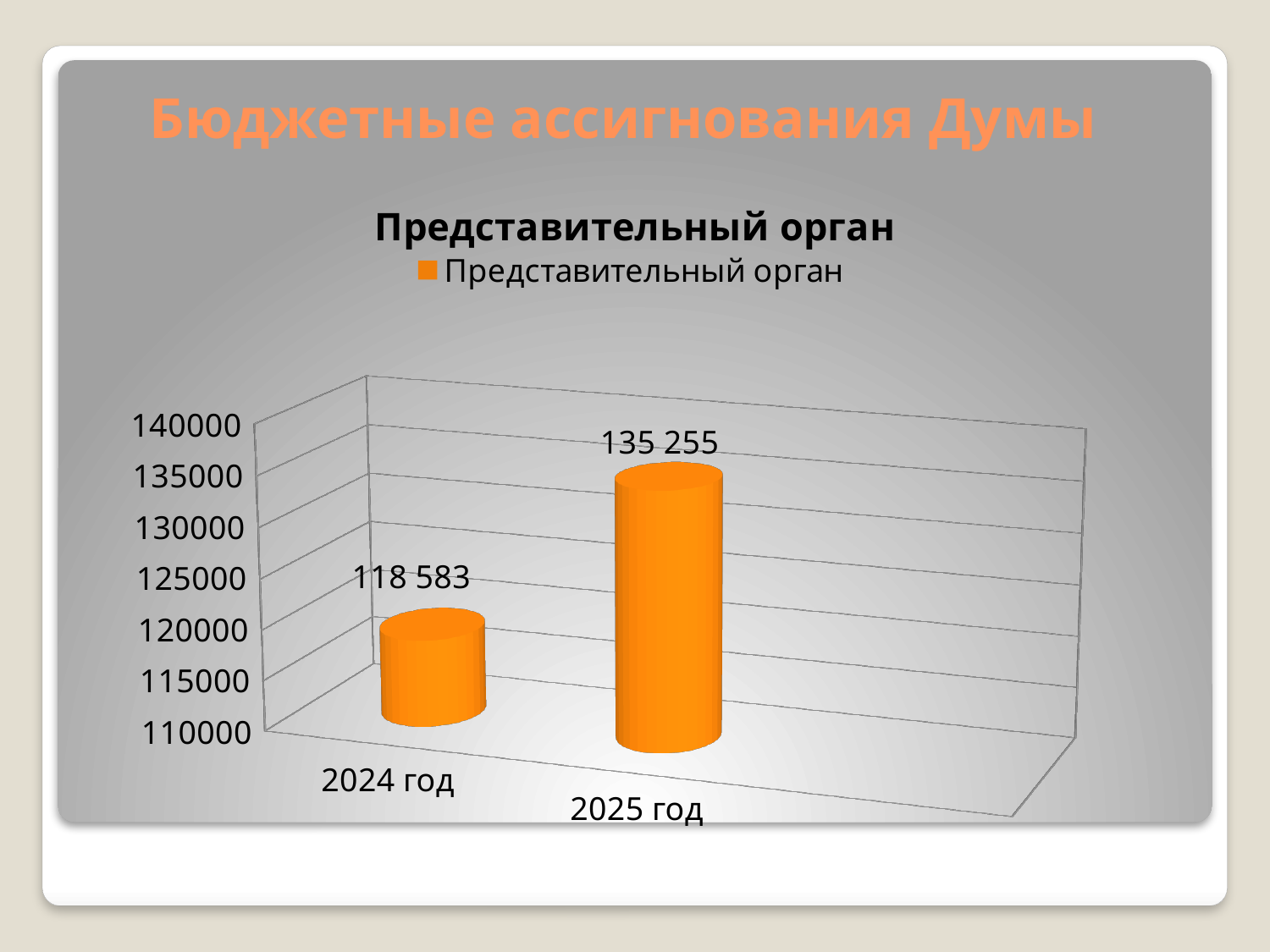
Which year has the lowest value? 2024 год What is the difference between the values for 2025 год and 2024 год? 16 672 Which is larger, the value for 2024 год or the value for 2025 год? 2025 год What is the value for 2024 год? 118 583 Which year has the highest value? 2025 год What kind of chart is shown? bar chart How many categories are shown on the x axis? 2 Is the value for 2024 год greater or less than 120000? less Is the value for 2025 год greater or less than 130000? greater How many series does the legend list? 1 Do the values rise or fall from 2024 год to 2025 год? rise What is the value for 2025 год? 135 255